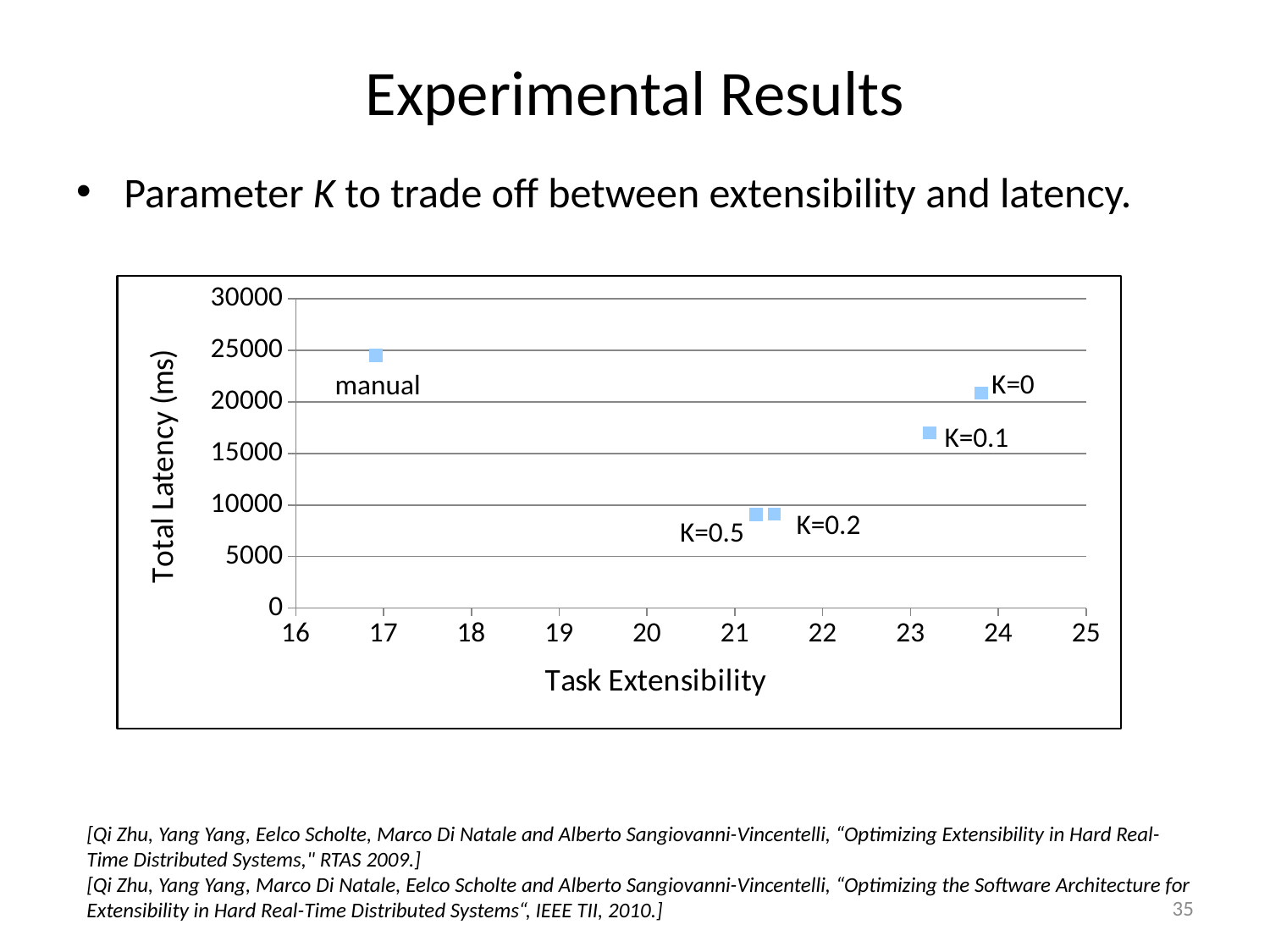
Is the Total Latency for the manual point greater or less than 20000? greater Is the Total Latency for K=0.1 greater or less than 20000? less Which has the higher Total Latency, K=0 or K=0.1? K=0 Which point has the highest Total Latency? manual What kind of chart is shown on the slide? scatter chart What is the title of the x axis of the chart? Task Extensibility Which has the higher Total Latency, manual or K=0? manual How many data points are plotted on the chart? 5 Is the Total Latency for K=0.5 greater or less than 10000? less Which point has the lowest Task Extensibility? manual Which point has the highest Task Extensibility? K=0